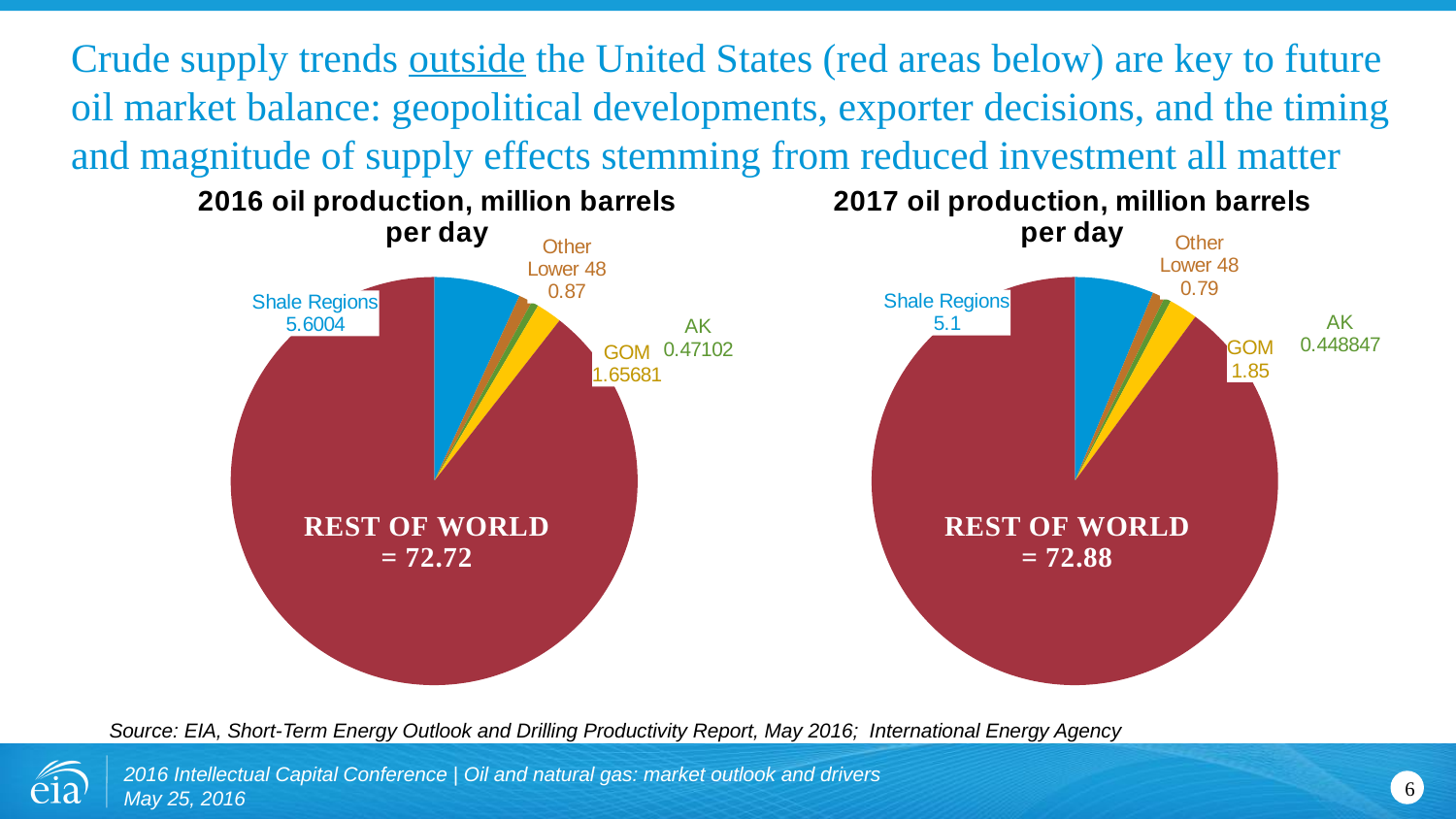
How many categories are shown in the 2017 oil production pie chart? 5 In the 2016 oil production chart, what is the value for Shale Regions? 5.6004 In the 2017 oil production chart, what is the value for Other Lower 48? 0.79 What is the difference between the Rest of World value in the 2017 chart and the 2016 chart? 0.16 In the 2017 oil production chart, what is the value for Rest of World? 72.88 In the 2017 oil production chart, which category has the smallest slice? AK What kind of chart is the "2016 oil production, million barrels per day" chart? pie chart In the 2016 oil production chart, what is the value for GOM? 1.65681 What is the difference between the Shale Regions value in the 2016 chart (5.6004) and in the 2017 chart (5.1)? 0.5004 Is the GOM value larger in the 2016 oil production chart or the 2017 oil production chart? 2017 In the 2016 oil production chart, which category has the largest slice? Rest of World In the 2017 oil production chart, what is the value for AK? 0.448847